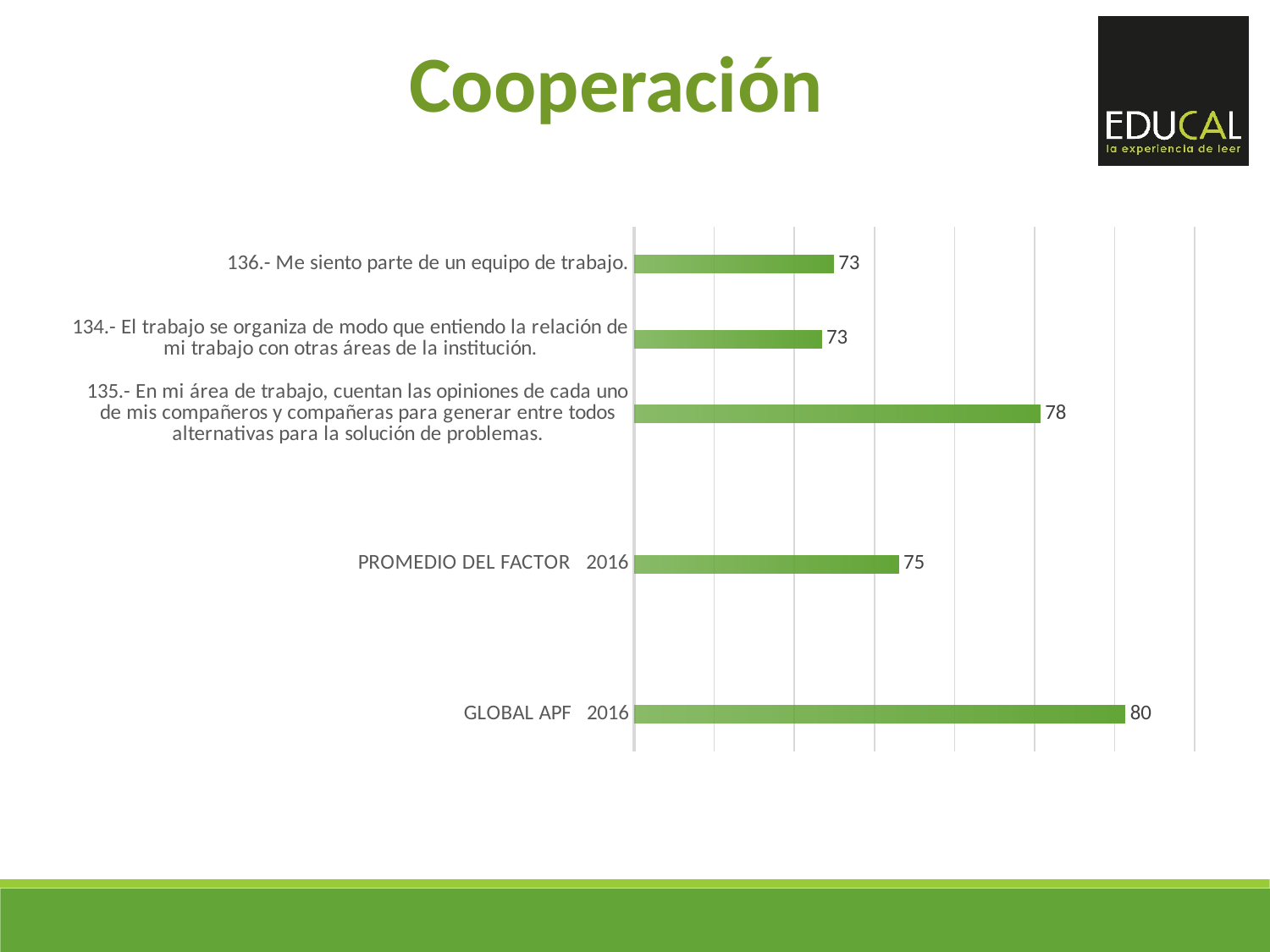
What is the value for GLOBAL APF 2016? 80 What is the value for item 134 (El trabajo se organiza de modo que entiendo la relación de mi trabajo con otras áreas de la institución)? 73 What is the value for PROMEDIO DEL FACTOR 2016? 75 How many bars are shown in the chart? 5 Which category has the highest value? GLOBAL APF 2016 What is the value for item 136 (Me siento parte de un equipo de trabajo)? 73 What kind of chart is shown on the slide? Bar chart What is the difference between the value for GLOBAL APF 2016 and the value for PROMEDIO DEL FACTOR 2016? 5 What is the value for item 135 (En mi área de trabajo, cuentan las opiniones de cada uno de mis compañeros y compañeras...)? 78 What is the difference between the value for item 135 and the value for item 136? 5 Which is larger, the value for item 135 or the value for PROMEDIO DEL FACTOR 2016? Item 135 What is the lowest value shown in the chart? 73